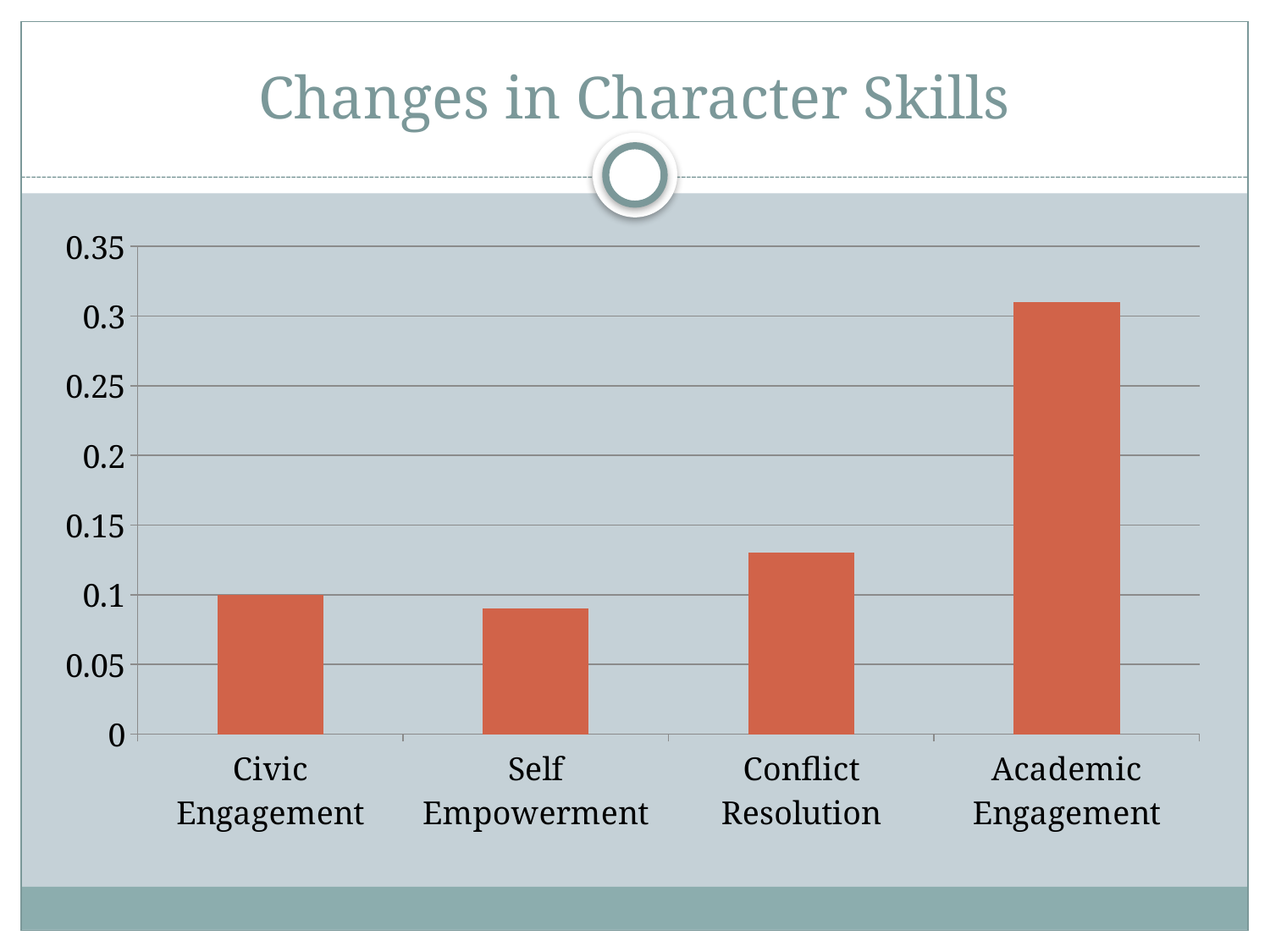
Which category has the lowest value? Self Empowerment What is the title of the slide? Changes in Character Skills What kind of chart is shown on the slide? Bar chart What is the value for Civic Engagement? 0.1 Which is larger, the value for Academic Engagement or the value for Conflict Resolution? Academic Engagement Is the value for Self Empowerment greater or less than 0.1? less Which category has the highest value? Academic Engagement Is the value for Conflict Resolution greater or less than 0.15? less Is the value for Conflict Resolution greater or less than 0.1? greater Which is larger, the value for Conflict Resolution or the value for Civic Engagement? Conflict Resolution How many categories are shown on the x axis? 4